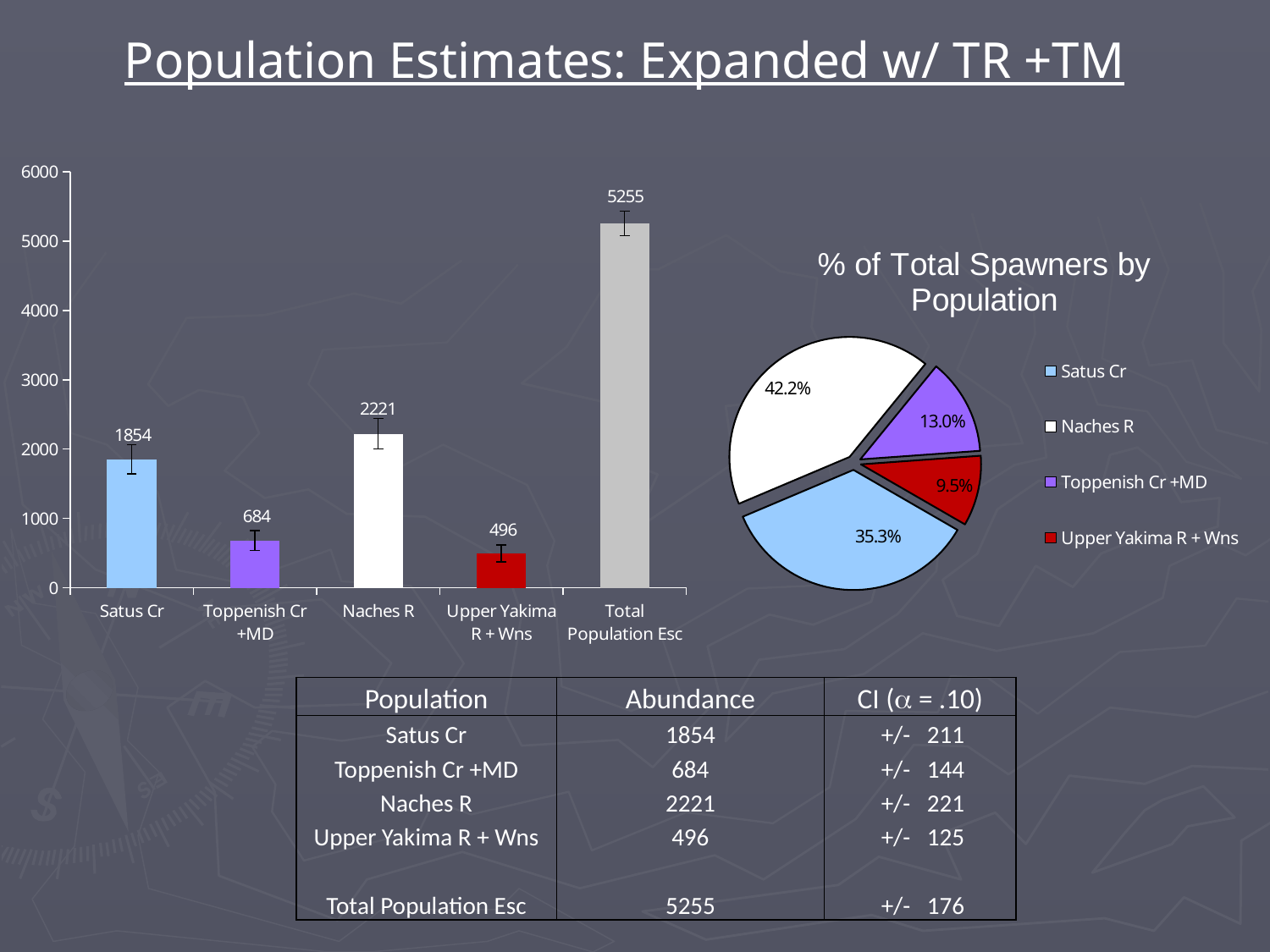
In the bar chart on the left, what is the difference between the values for Naches R and Satus Cr? 367 In the bar chart on the left, what is the value for Upper Yakima R + Wns? 496 In the pie chart '% of Total Spawners by Population', what share does Naches R have? 42.2% In the bar chart on the left, which category has the lowest value? Upper Yakima R + Wns How many entries does the legend of the pie chart '% of Total Spawners by Population' list? 4 In the bar chart on the left, how many categories are shown on the x axis? 5 In the bar chart on the left, what is the value for Total Population Esc? 5255 In the bar chart on the left, which is larger, the value for Toppenish Cr +MD or the value for Upper Yakima R + Wns? Toppenish Cr +MD What kind of chart is the chart on the left of the slide? Bar chart In the bar chart on the left, what is the value for Naches R? 2221 In the pie chart '% of Total Spawners by Population', which population has the smallest slice? Upper Yakima R + Wns In the bar chart on the left, which category has the highest value? Total Population Esc